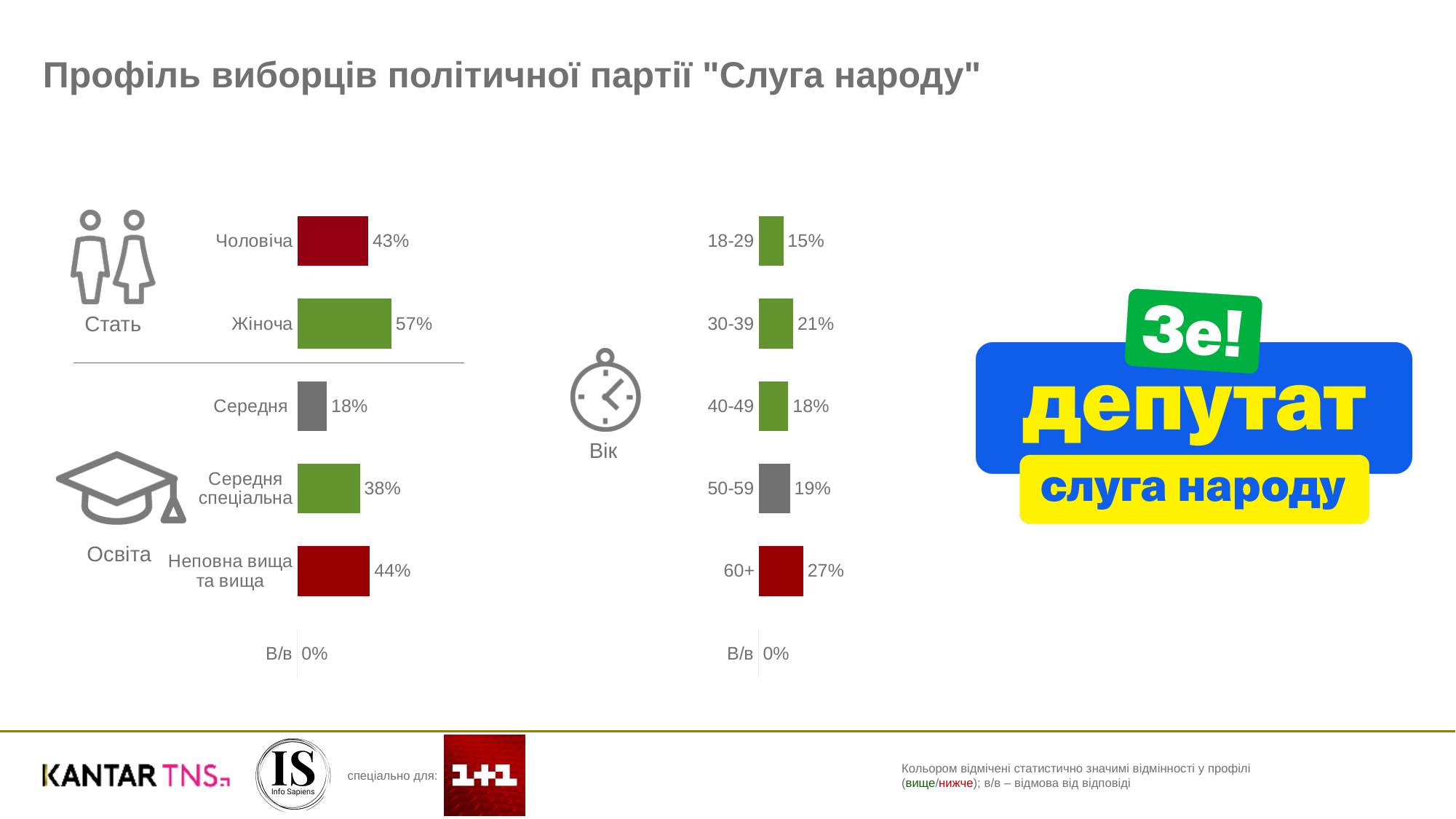
In the Освіта (education) chart, what is the difference between Неповна вища та вища and Середня? 26% In the Освіта (education) chart, what is the value for Середня спеціальна? 38% In the Вік (age) chart, what is the value for 60+? 27% What type of chart is used in the Вік (age) section? Bar chart In the Стать (gender) chart, what is the difference between Жіноча and Чоловіча? 14% In the Вік (age) chart, what is the value for В/в? 0% In the Освіта (education) chart, which category has the highest value? Неповна вища та вища In the Вік (age) chart, which age group has the lowest non-zero value? 18-29 In the Вік (age) chart, which is larger: 30-39 or 40-49? 30-39 In the Стать (gender) chart, what is the value for Чоловіча? 43% In the Вік (age) chart, how many age groups (excluding В/в) are shown? 5 In the Стать (gender) chart, what is the value for Жіноча? 57%